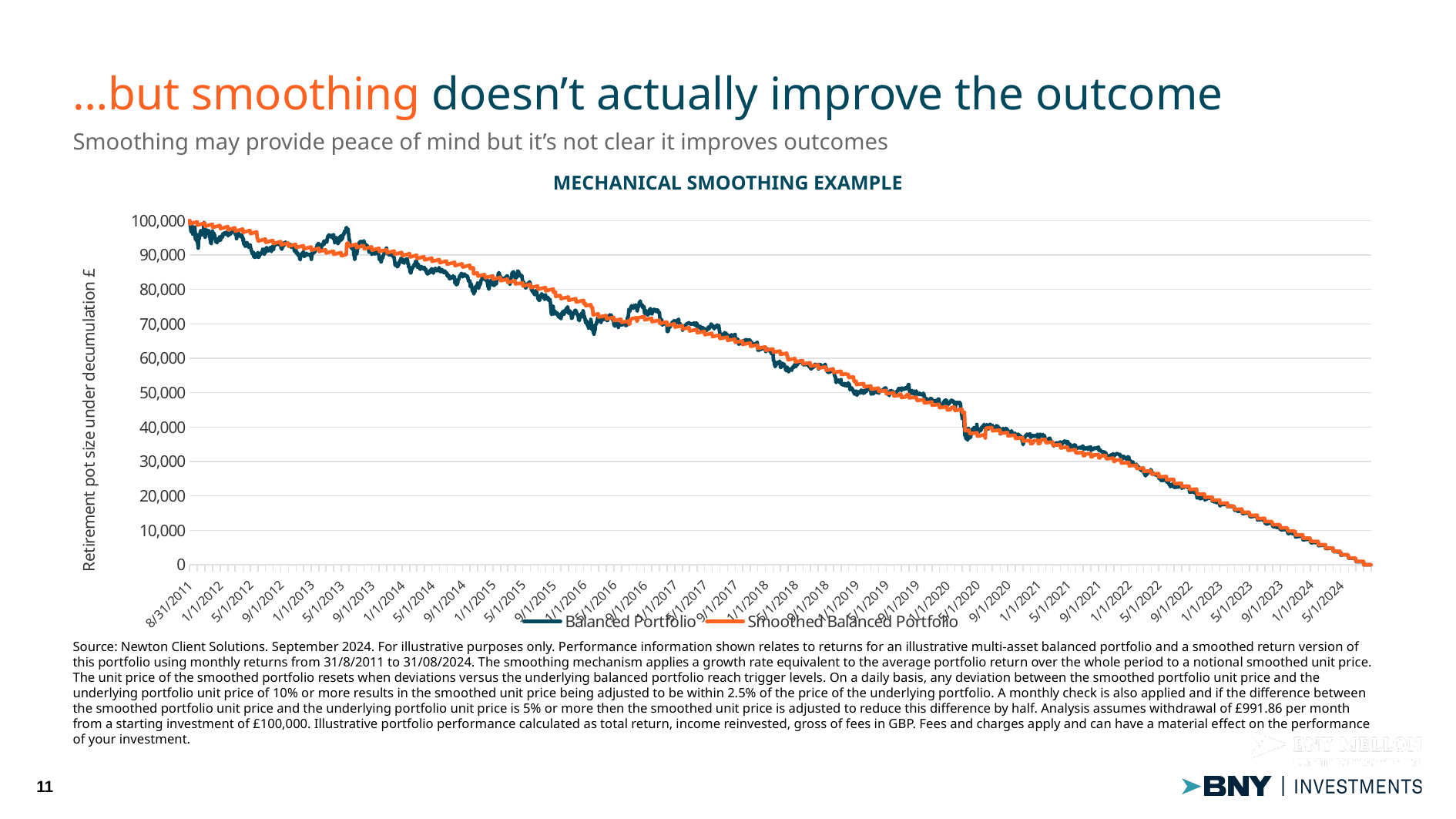
Is the value for the Smoothed Balanced Portfolio at 5/1/2014 greater or less than 80,000? greater What is the title of the chart? MECHANICAL SMOOTHING EXAMPLE Is the value for the Balanced Portfolio at 5/1/2013 greater or less than 90,000? greater What is the label on the vertical axis of the chart? Retirement pot size under decumulation £ Do the values of the Smoothed Balanced Portfolio series rise or fall from 8/31/2011 to 5/1/2024? Fall Do the values of the Balanced Portfolio series rise or fall over time along the x axis? Fall What is the highest value shown on the vertical axis of the chart? 100,000 What kind of chart is shown on the slide? Line chart Is the value for the Smoothed Balanced Portfolio at 9/1/2022 greater or less than 30,000? less How many series does the legend list? 2